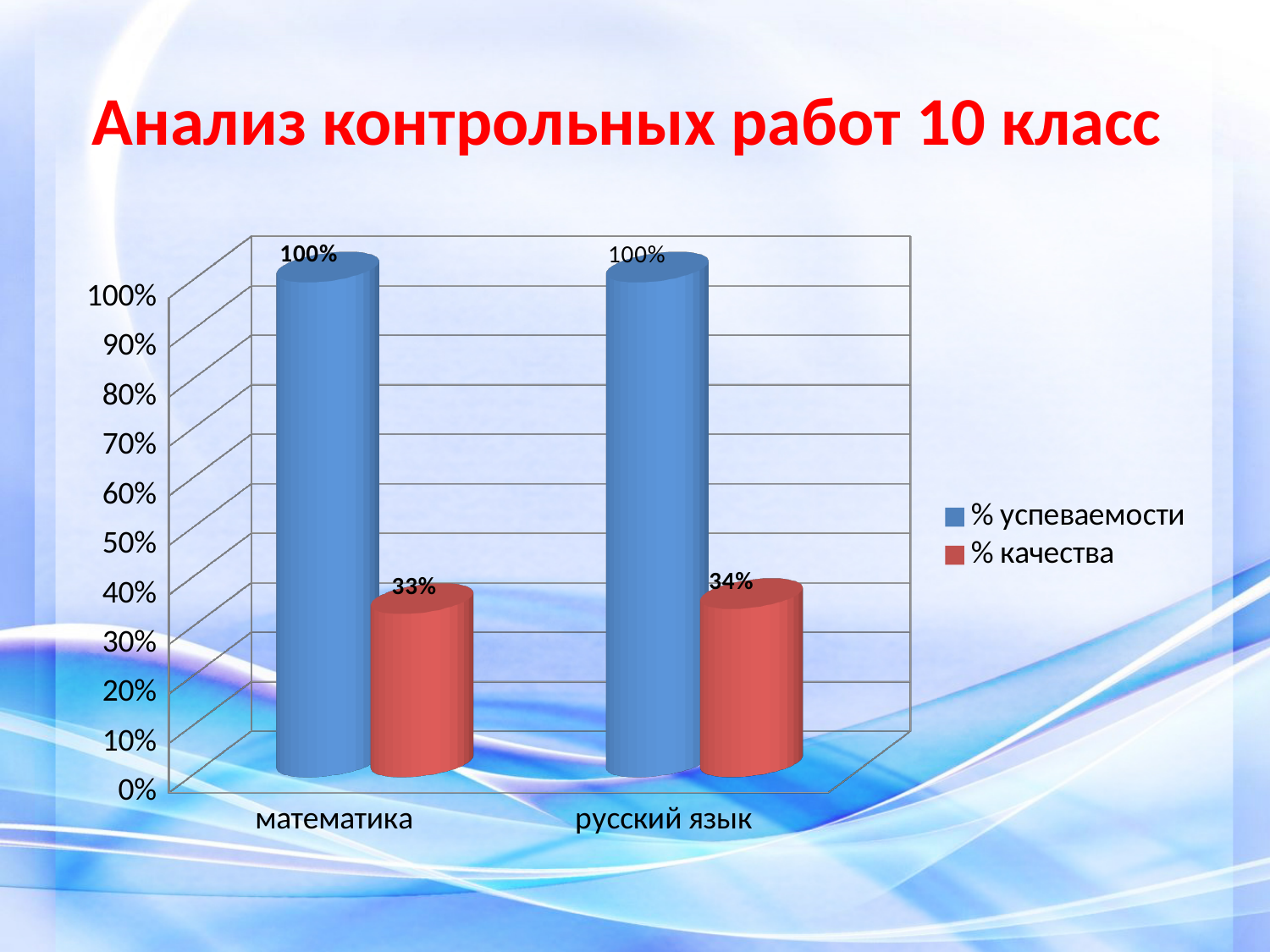
How many series does the legend list? 2 What is the % успеваемости value for русский язык? 100% How many subjects are shown on the x axis? 2 What is the difference between % успеваемости and % качества for математика? 67% What is the difference between % успеваемости and % качества for русский язык? 66% Which colour represents % качества in the legend? red Which subject has the higher % качества? русский язык What kind of chart is shown on the slide? bar chart What is the % качества value for математика? 33% What is the % качества value for русский язык? 34% What is the % успеваемости value for математика? 100% Is the % качества value for математика greater or less than 50%? less